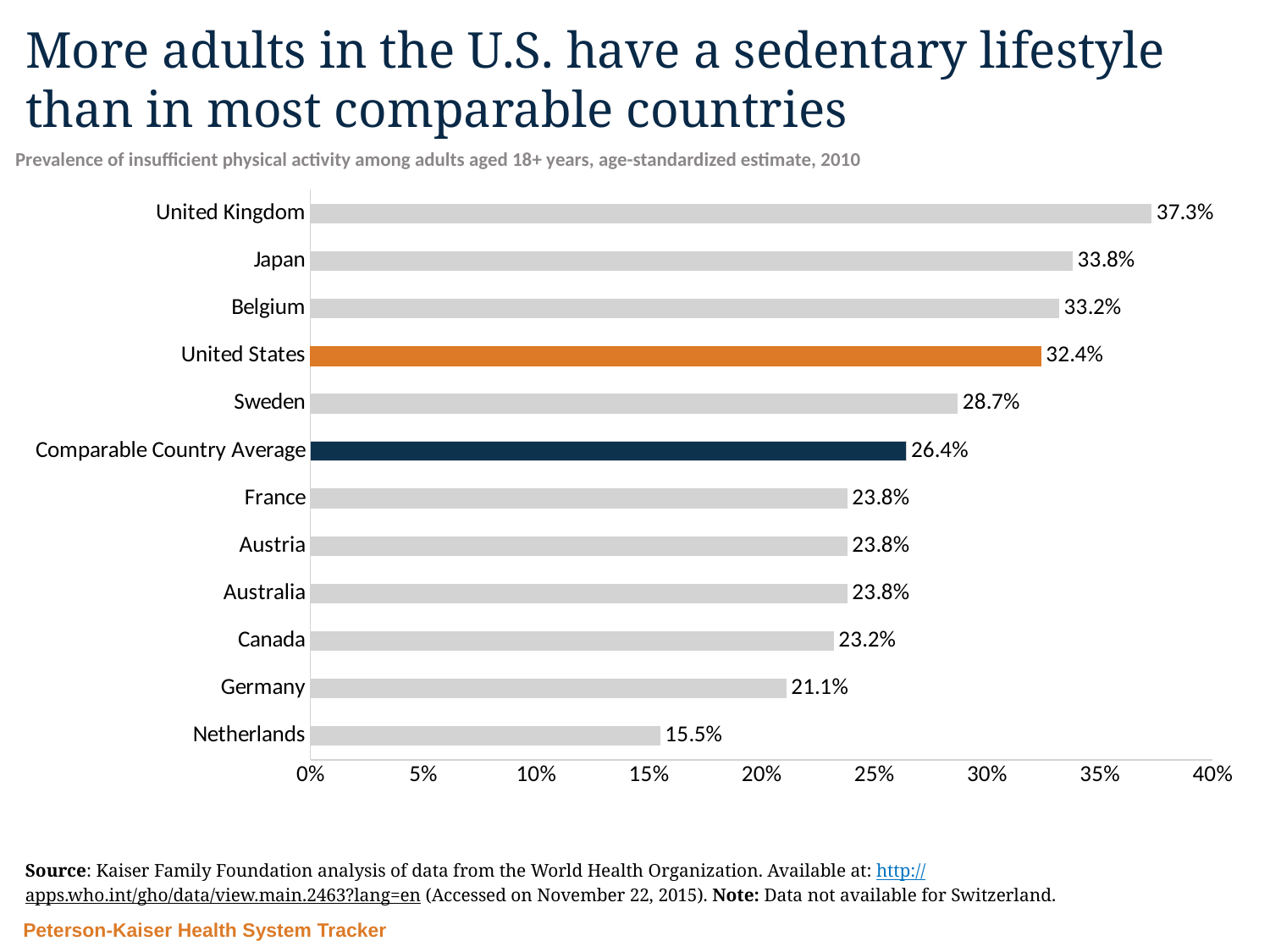
What is the difference between the United Kingdom and Netherlands values? 21.8% Which country has the highest prevalence of insufficient physical activity? United Kingdom Is the value for Germany greater or less than 25%? less Which is larger, the value for Japan or the value for Belgium? Japan Which country has the lowest prevalence of insufficient physical activity? Netherlands What is the value for the Comparable Country Average? 26.4% What is the difference between the United States value and the Comparable Country Average? 6.0% How many bars are shown in the chart? 12 What is the value for Sweden? 28.7% What kind of chart is shown on the slide? Bar chart Which bar is coloured orange? United States What is the value for the United States? 32.4%